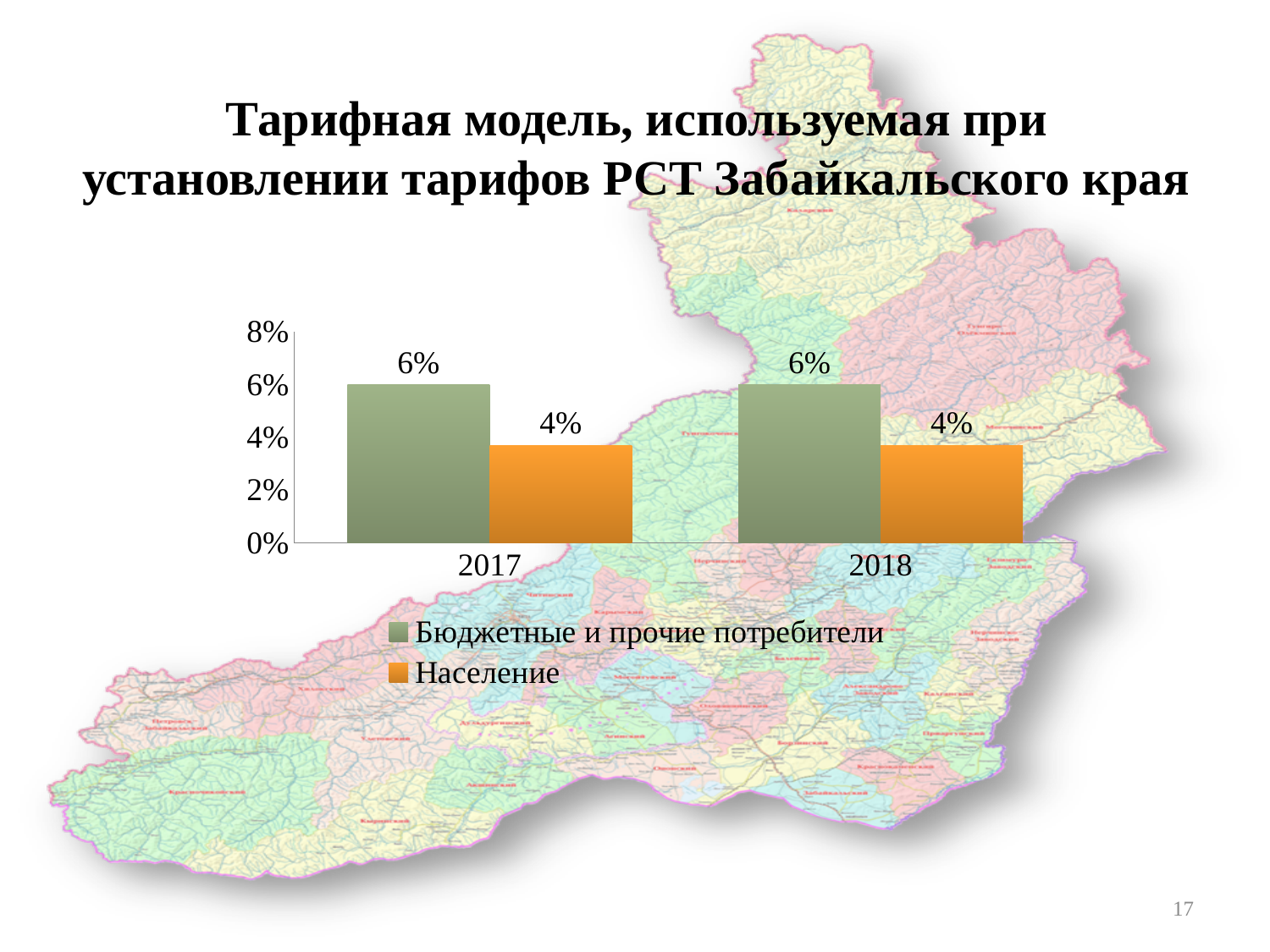
What is the difference between Бюджетные и прочие потребители and Население in 2017? 2% Does the value for Население rise, fall or stay the same from 2017 to 2018? stays the same What is the value for Население in 2018? 4% How many categories are shown on the x axis? 2 What is the value for Население in 2017? 4% Is the value for Население in 2017 greater or less than 6%? less Which colour represents Население in the chart? orange What is the value for Бюджетные и прочие потребители in 2018? 6% Which series has the larger value in 2018, Бюджетные и прочие потребители or Население? Бюджетные и прочие потребители How many series does the legend list? 2 What is the value for Бюджетные и прочие потребители in 2017? 6% What kind of chart is shown on the slide? bar chart